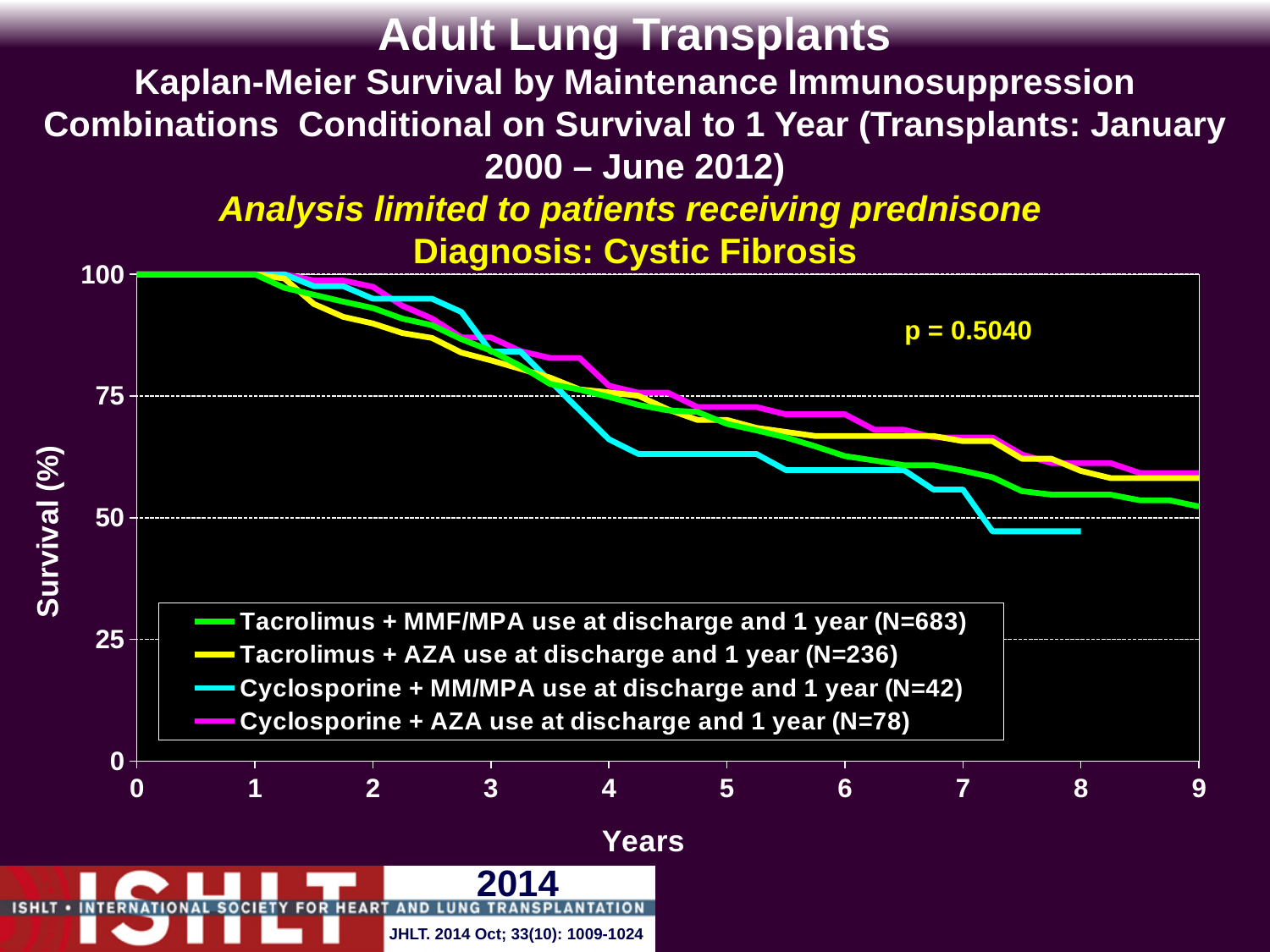
How many series does the legend list? 4 What is the p-value printed on the chart? p = 0.5040 At year 4, which is higher: the Cyclosporine + MM/MPA curve or the Cyclosporine + AZA curve? Cyclosporine + AZA What is the N for the Cyclosporine + MM/MPA use at discharge and 1 year series? N=42 Is the survival value for Cyclosporine + MM/MPA at year 8 greater or less than 50? less Do the survival curves rise or fall as years increase? fall What kind of chart is shown on the slide? line chart What is the label of the y-axis? Survival (%) What is the N for the Cyclosporine + AZA use at discharge and 1 year series? N=78 What is the N for the Tacrolimus + MMF/MPA use at discharge and 1 year series? N=683 Is the survival value for Cyclosporine + AZA at year 9 greater or less than 75? less Which series has the lowest survival at year 8? Cyclosporine + MM/MPA use at discharge and 1 year (N=42)